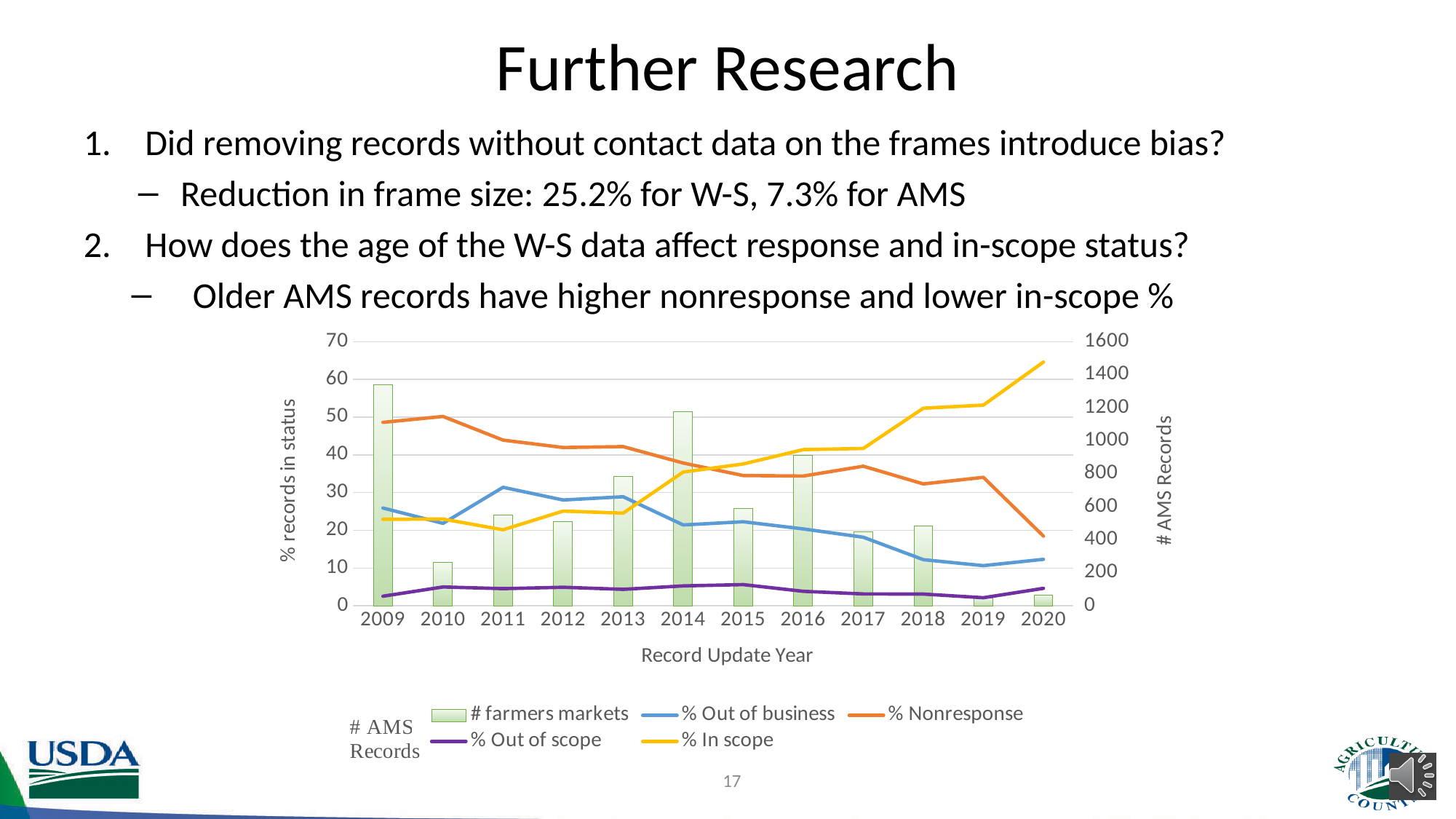
Is the % In scope value for 2020 greater or less than 60? greater Which year has the lowest number of farmers markets (shortest bar)? 2019 What is the title of the chart's x axis? Record Update Year Which year has the highest number of farmers markets (tallest bar)? 2009 Which year has the lowest % Nonresponse value? 2020 Is the % Nonresponse value for 2009 greater or less than 40? greater What kind of chart is shown on the slide? A combination bar and line chart In 2020, which is larger: % In scope or % Nonresponse? % In scope Does the % Nonresponse line generally rise or fall from 2009 to 2020? Fall Does the % In scope line generally rise or fall from 2009 to 2020? Rise How many series does the chart's legend list? 5 How many years are shown on the x axis of the chart? 12